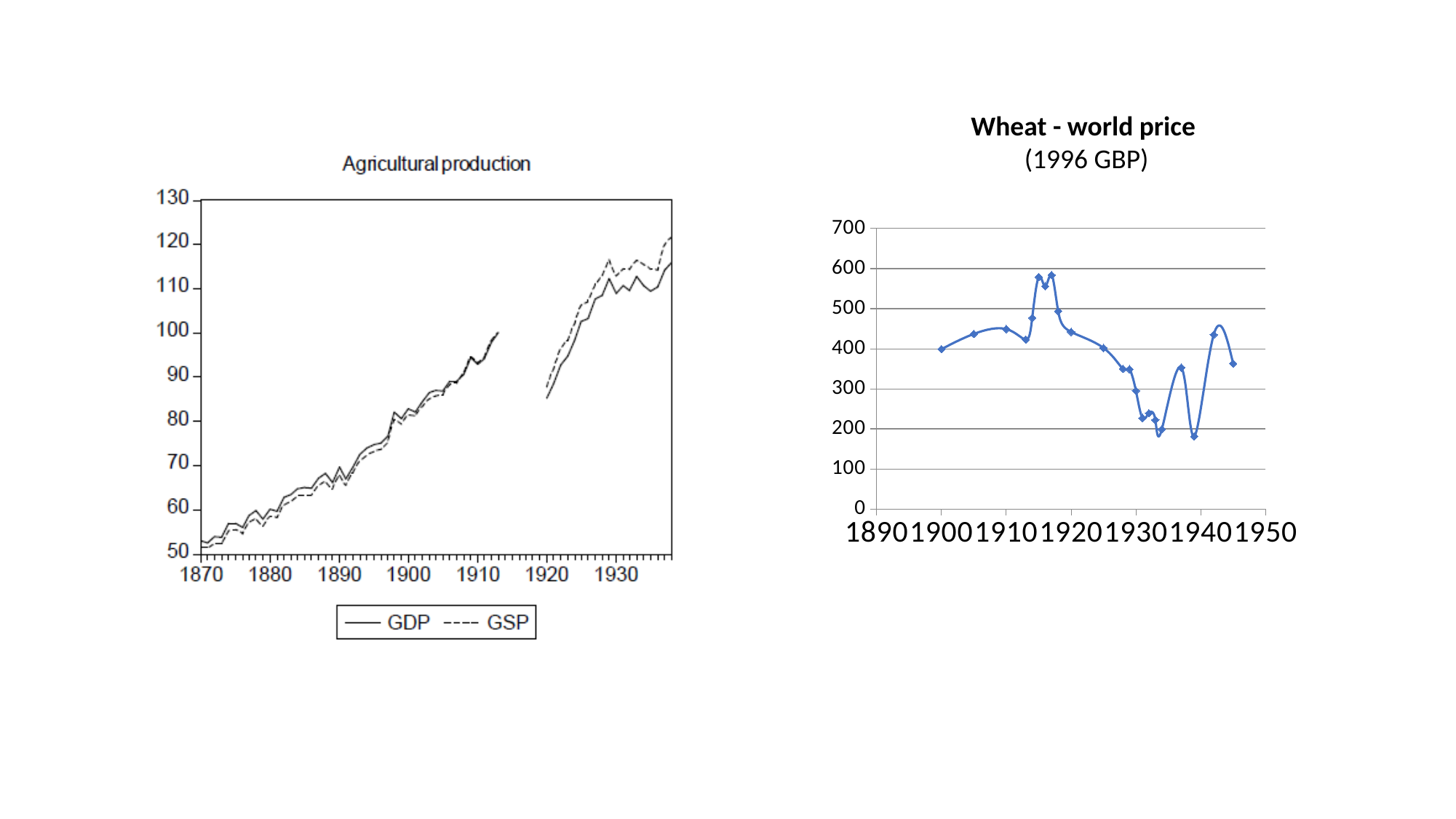
In the 'Wheat - world price' chart, is the lowest value greater or less than 200? less What kind of chart is the 'Wheat - world price' chart on the right? line chart In the 'Wheat - world price' chart, is the highest value greater or less than 500? greater In the 'Agricultural production' chart, is the GDP value in 1870 greater or less than 60? less What unit is given in the subtitle of the 'Wheat - world price' chart? 1996 GBP In the 'Agricultural production' chart, which series is drawn with a dashed line? GSP How many series does the legend of the 'Agricultural production' chart list? 2 In the 'Wheat - world price' chart, does the price rise or fall between 1920 and 1930? fall What kind of chart is the 'Agricultural production' chart on the left? line chart In the 'Agricultural production' chart, do the GDP and GSP values generally rise or fall from 1870 to 1910? rise